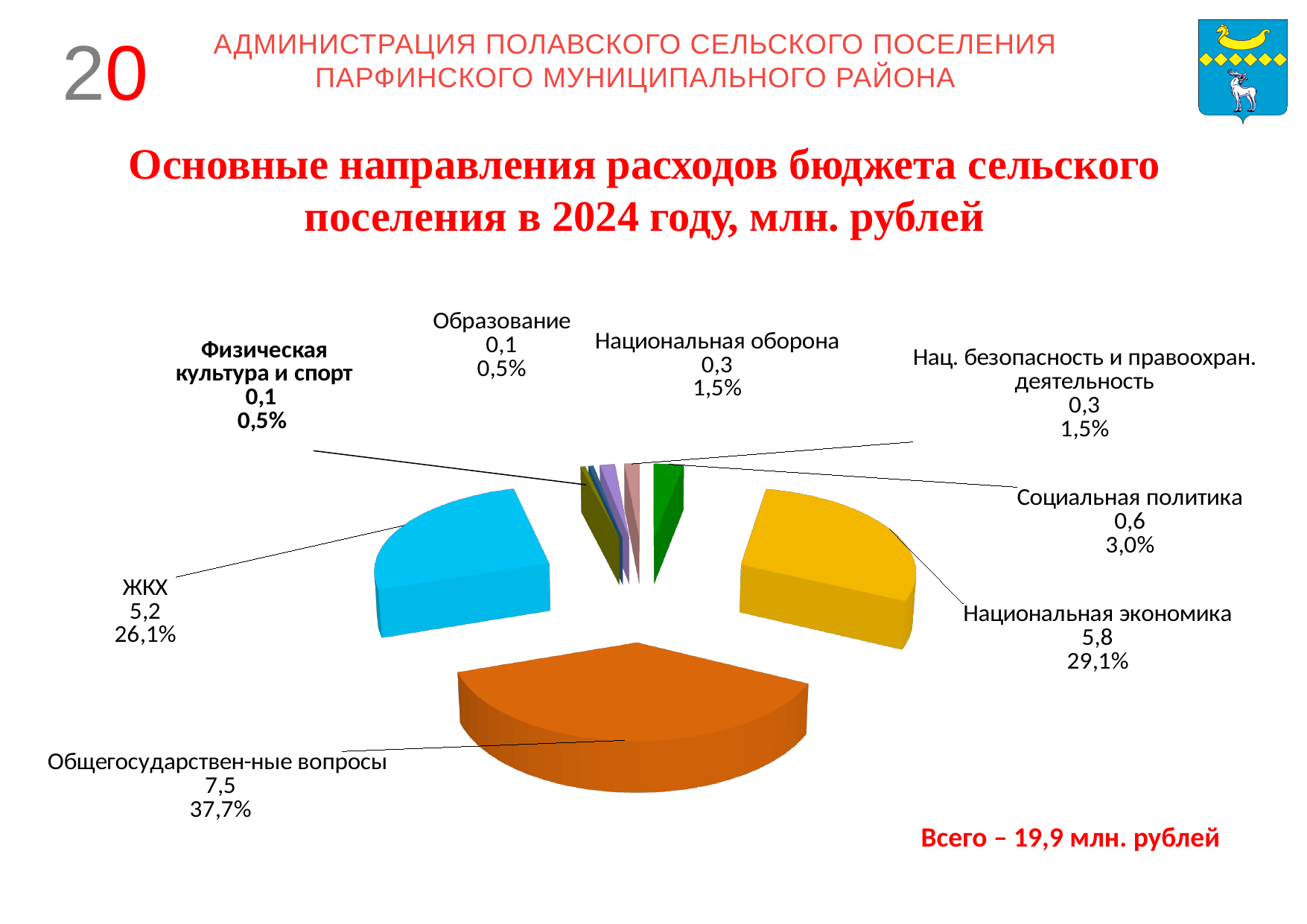
What share of the pie does Нац. безопасность и правоохран. деятельность have? 1,5% How many categories does the pie chart show? 8 What is the difference between the values for Национальная экономика and ЖКХ? 0,6 What total amount in million rubles is stated on the slide? 19,9 млн. рублей What share of the pie does Национальная экономика have? 29,1% Which category has the largest slice of the pie? Общегосударственные вопросы Which is larger, the value for Социальная политика or the value for Национальная оборона? Социальная политика What is the value for ЖКХ? 5,2 What is the value for Общегосударственные вопросы? 7,5 What type of chart is shown on the slide? Pie chart What is the value for Образование? 0,1 What share of the pie does Социальная политика have? 3,0%